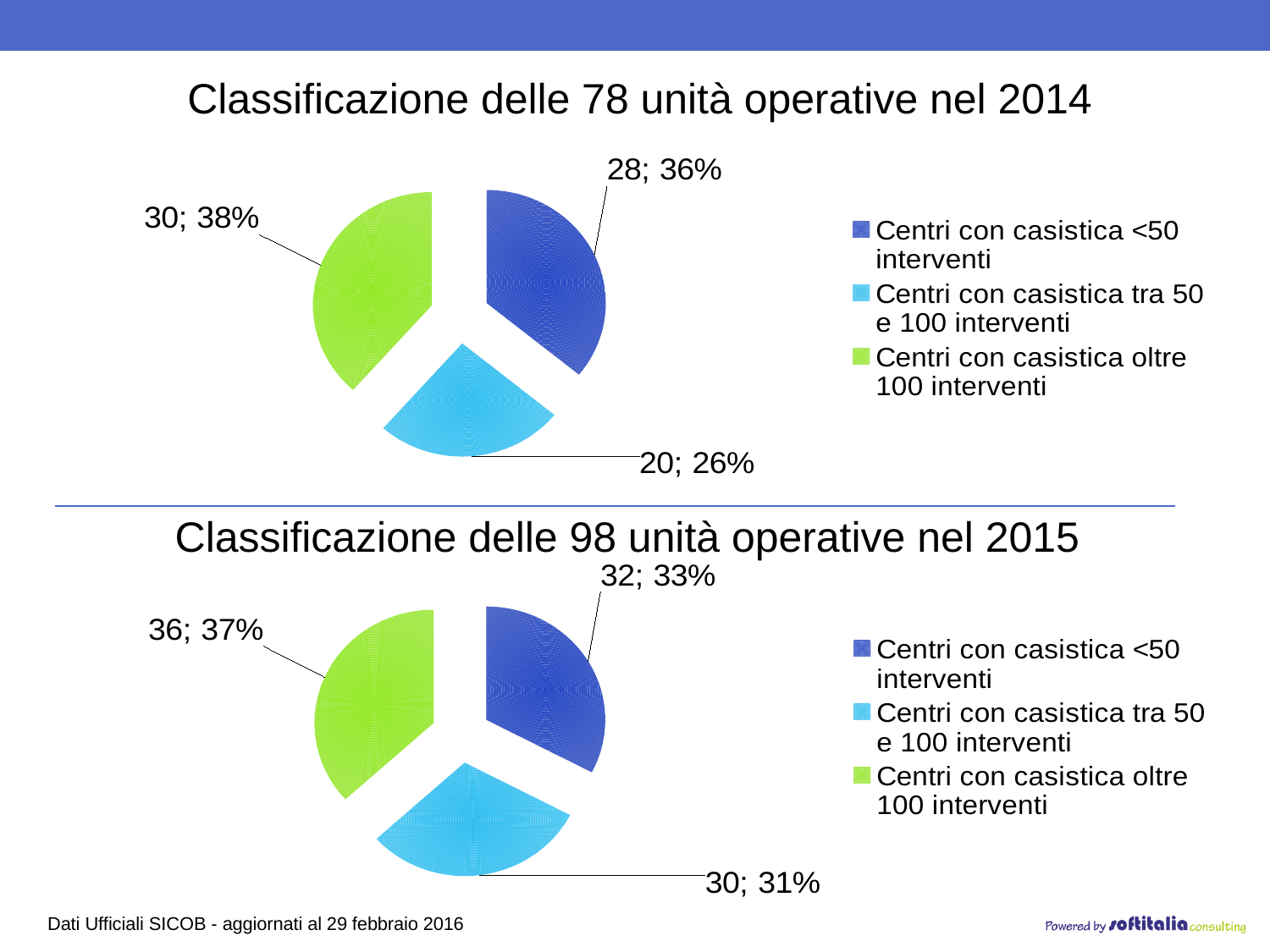
In the 2015 chart (bottom), what share of the pie is 'Centri con casistica <50 interventi'? 33% In the 2015 chart (bottom), how many units are in the category 'Centri con casistica tra 50 e 100 interventi'? 30 In the 2015 chart (bottom), what is the difference in units between 'Centri con casistica oltre 100 interventi' and 'Centri con casistica <50 interventi'? 4 What type of chart is used for the 2014 classification (top)? Pie chart In the 2014 chart (top), which category has the largest slice? Centri con casistica oltre 100 interventi In the 2015 chart (bottom), which category has the largest slice? Centri con casistica oltre 100 interventi In the 2014 chart (top), what is the difference in units between 'Centri con casistica oltre 100 interventi' and 'Centri con casistica tra 50 e 100 interventi'? 10 In the 2014 chart (top), which category has the smallest slice? Centri con casistica tra 50 e 100 interventi How many categories does each pie chart on the slide have? 3 In the 2014 chart (top), what share of the pie is 'Centri con casistica oltre 100 interventi'? 38% In the 2015 chart (bottom), which colour represents 'Centri con casistica oltre 100 interventi'? Green In the 2014 chart (top), how many units are in the category 'Centri con casistica <50 interventi'? 28